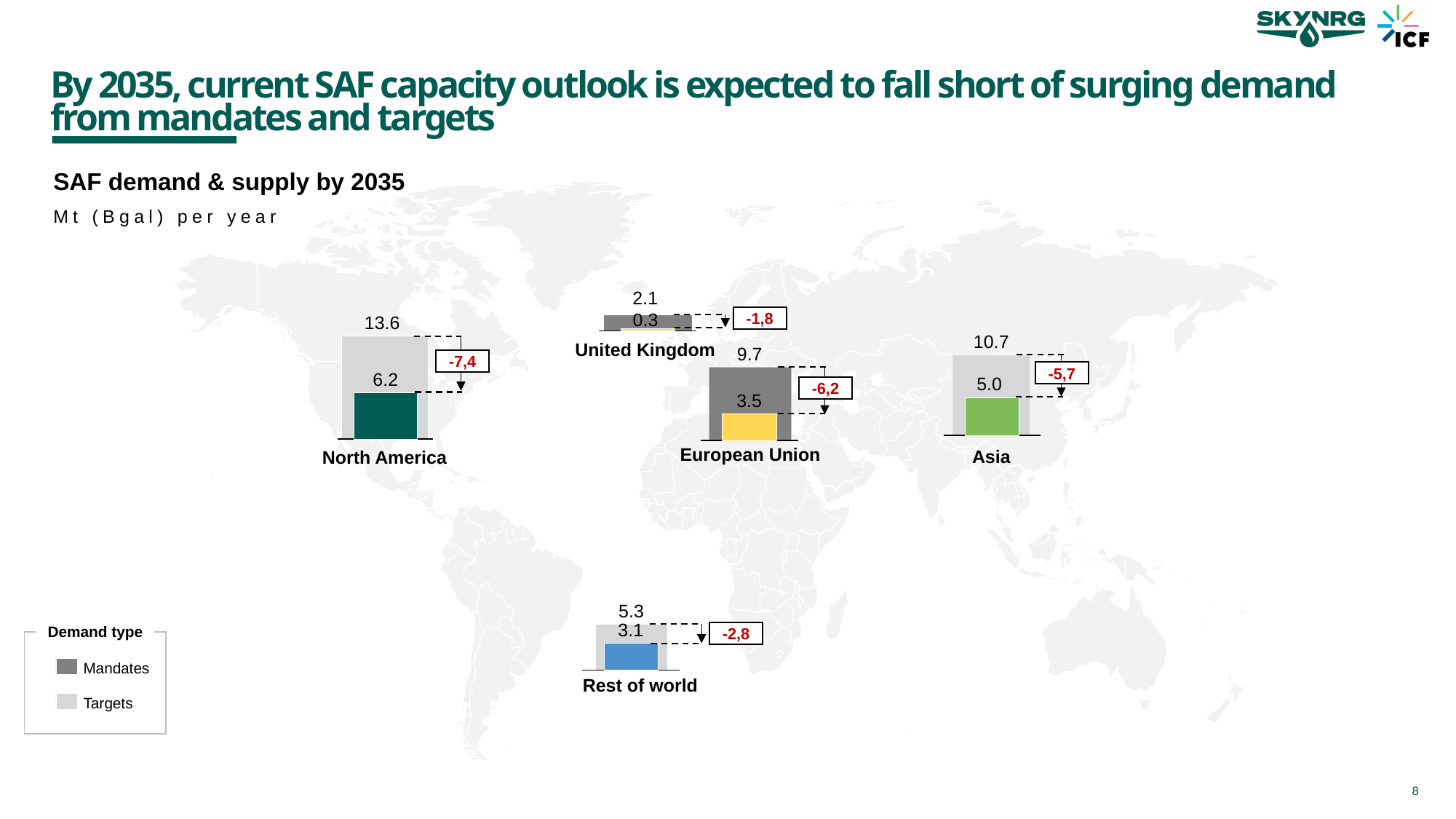
In the North America chart, what is the demand value shown? 13.6 In the United Kingdom chart, what is the supply value shown? 0.3 In the European Union chart, what is the mandate demand value? 9.7 Across the five regional charts, which region has the highest demand value by 2035? North America In the Asia chart, what gap between demand and supply is shown in the red label? -5,7 How many regional charts are shown on the map? 5 In the European Union chart, what is the difference between the demand value (9.7) and the supply value (3.5)? 6.2 In the North America chart, what is the supply value shown by the dark green bar? 6.2 Which is larger: the demand value in the Asia chart or the demand value in the European Union chart? Asia In the Rest of world chart, what is the demand value shown? 5.3 Across the five regional charts, which region has the lowest supply value by 2035? United Kingdom How many demand types does the legend list? 2